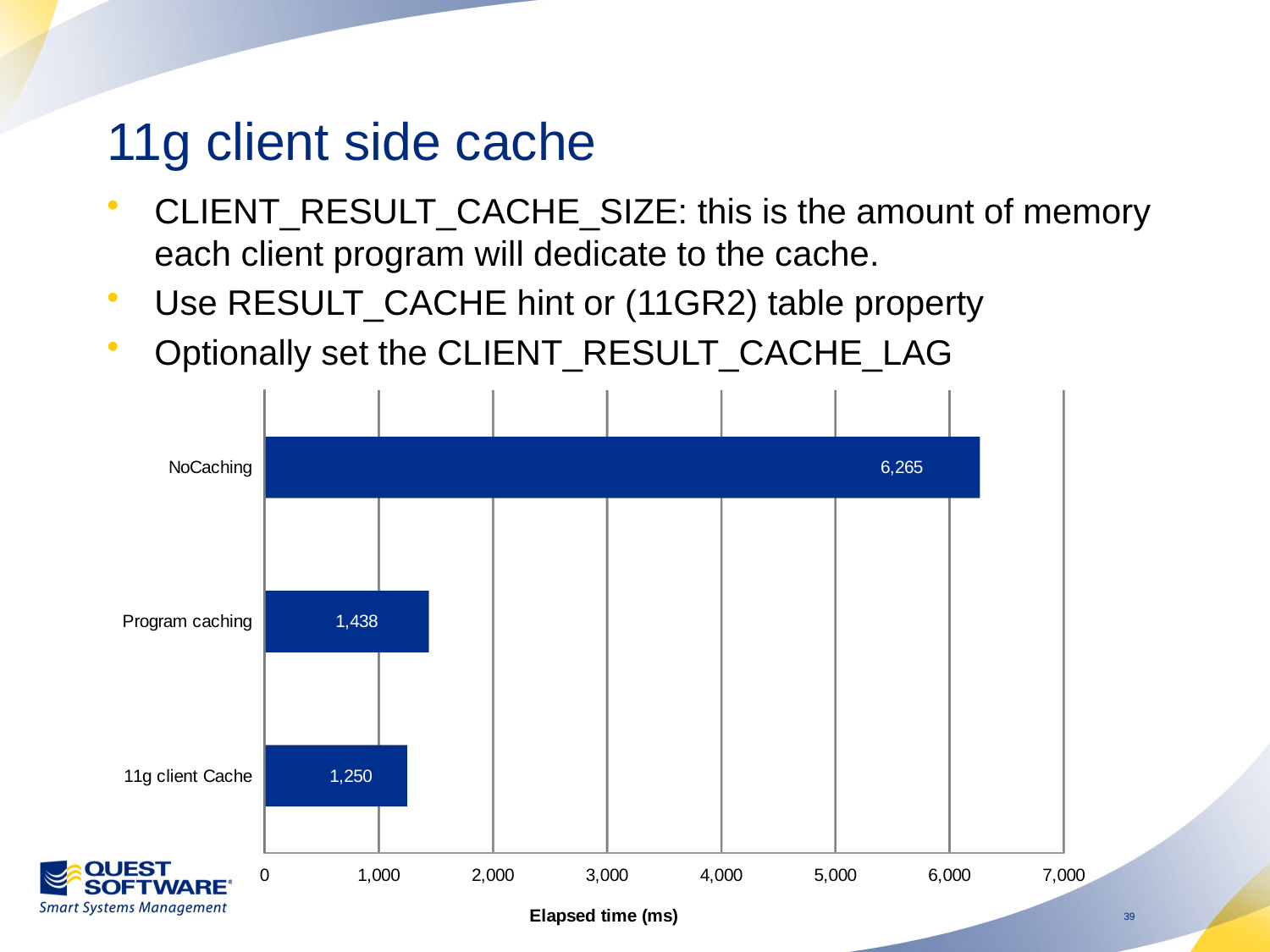
What is the elapsed time for NoCaching? 6,265 Is the value for NoCaching greater or less than 6,000? greater Which has a larger elapsed time, Program caching or 11g client Cache? Program caching What kind of chart is shown on the slide? bar chart What is the label of the horizontal axis? Elapsed time (ms) What is the elapsed time for Program caching? 1,438 What is the difference in elapsed time between Program caching and 11g client Cache? 188 Which category has the lowest elapsed time? 11g client Cache How many categories are shown in the chart? 3 Which category has the highest elapsed time? NoCaching What is the difference in elapsed time between NoCaching and 11g client Cache? 5,015 What is the elapsed time for 11g client Cache? 1,250